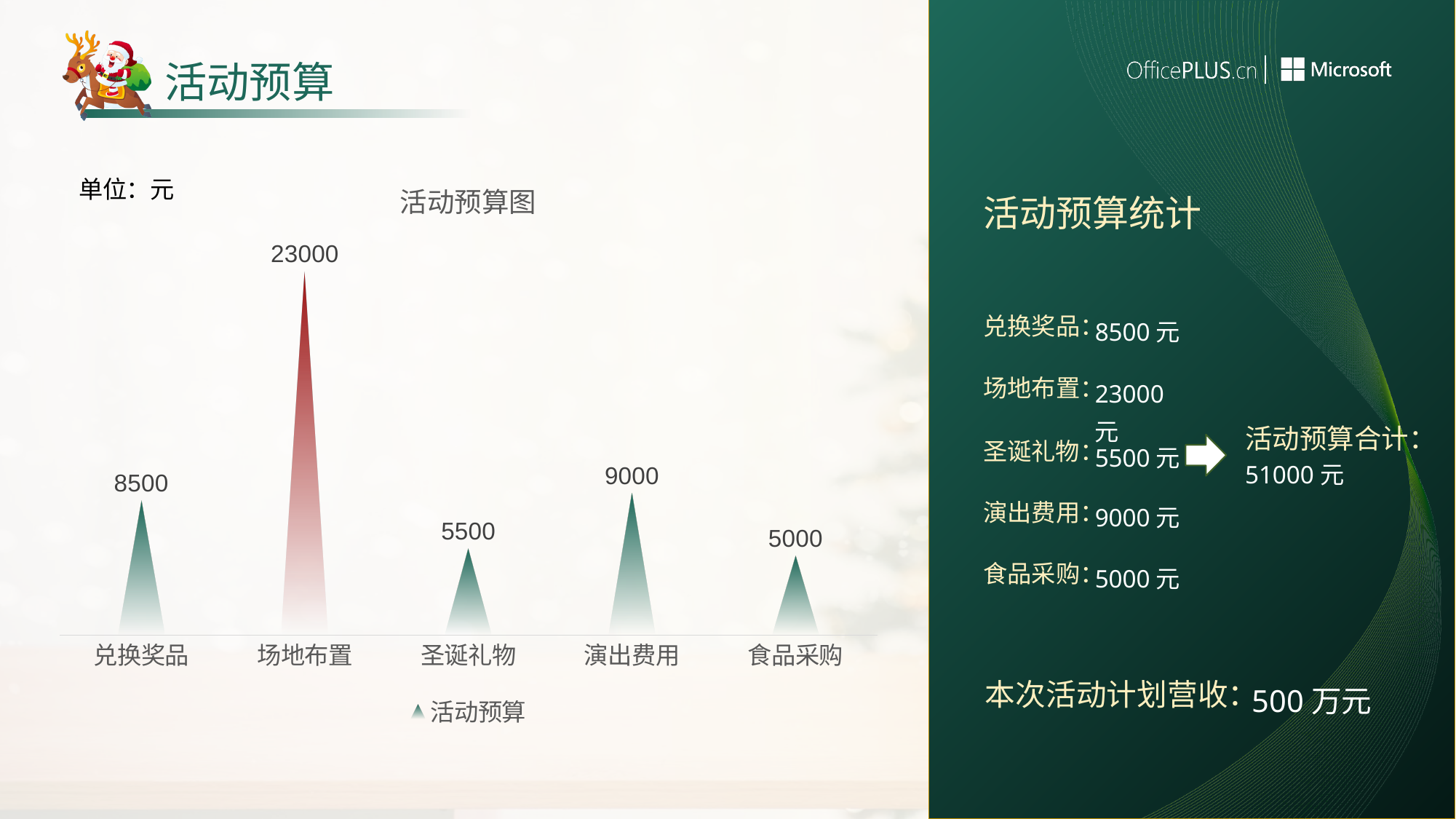
Which category has the highest value in the 活动预算图 chart? 场地布置 What is the value for 场地布置 in the 活动预算图 chart? 23000 What is the name of the series in the legend of the 活动预算图 chart? 活动预算 Which category has the lowest value in the 活动预算图 chart? 食品采购 How many categories are shown in the 活动预算图 chart? 5 What kind of chart is the 活动预算图? bar chart What is the value for 圣诞礼物 in the 活动预算图 chart? 5500 What is the value for 演出费用 in the 活动预算图 chart? 9000 How many series does the legend of the 活动预算图 chart list? 1 What is the difference between the values for 演出费用 and 食品采购 in the 活动预算图 chart? 4000 Which is larger in the 活动预算图 chart, 兑换奖品 or 演出费用? 演出费用 What is the difference between the values for 场地布置 and 兑换奖品 in the 活动预算图 chart? 14500